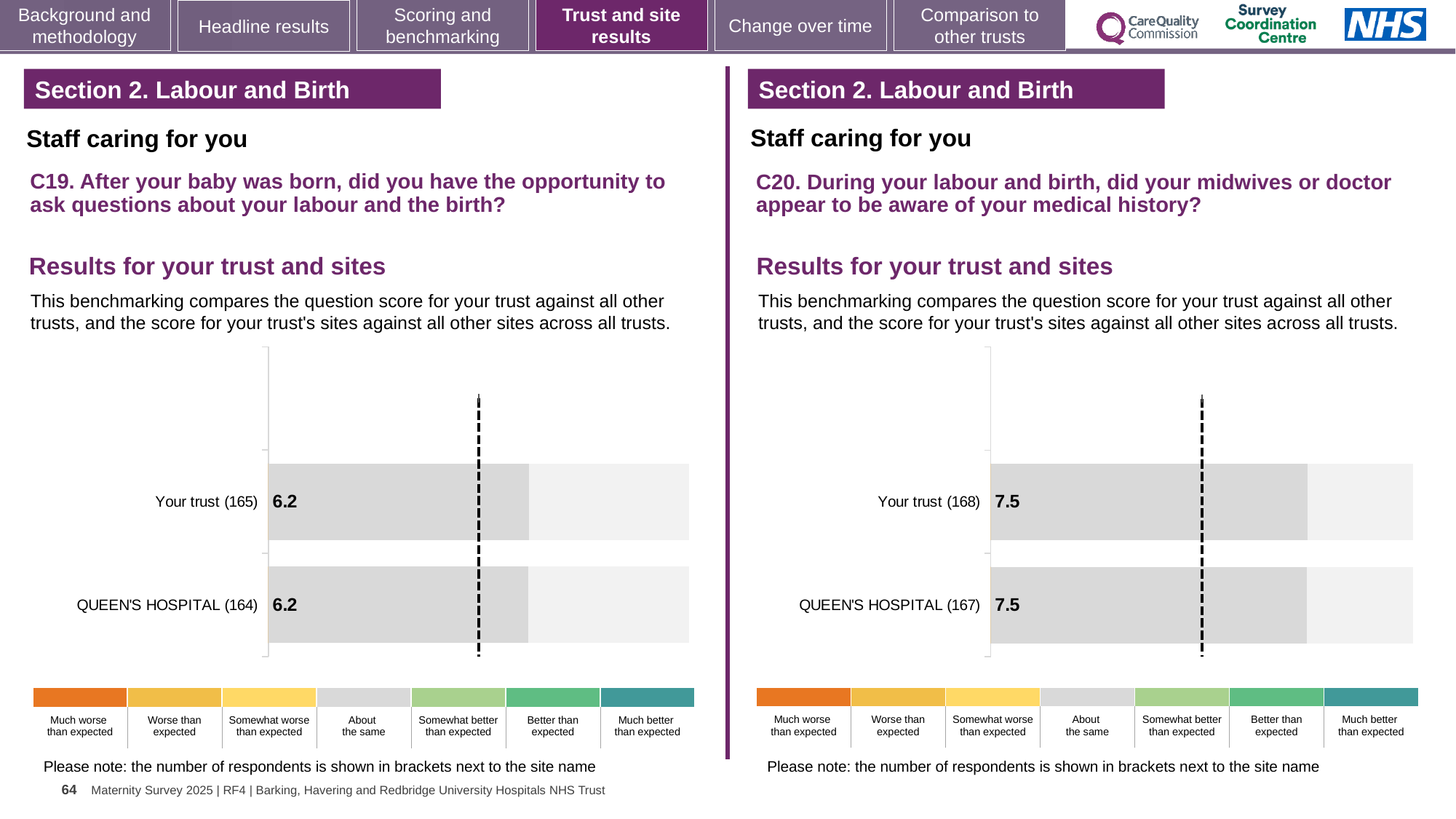
How many bars are plotted on the C19 chart (left)? 2 On the C19 chart (left), what is the score for Your trust? 6.2 On the C19 chart (left), how many respondents are shown in brackets for Your trust? 165 On the C20 chart (right), how many respondents are shown in brackets for QUEEN'S HOSPITAL? 167 On the C20 chart (right), what is the score for QUEEN'S HOSPITAL? 7.5 How many bars are plotted on the C20 chart (right)? 2 What kind of chart is the C19 chart (left)? Bar chart On the C20 chart (right), what is the score for Your trust? 7.5 On the C20 chart (right), what is the difference between the score for Your trust and the score for QUEEN'S HOSPITAL? 0 On the C19 chart (left), what is the score for QUEEN'S HOSPITAL? 6.2 On the C19 chart (left), what is the difference between the score for Your trust and the score for QUEEN'S HOSPITAL? 0